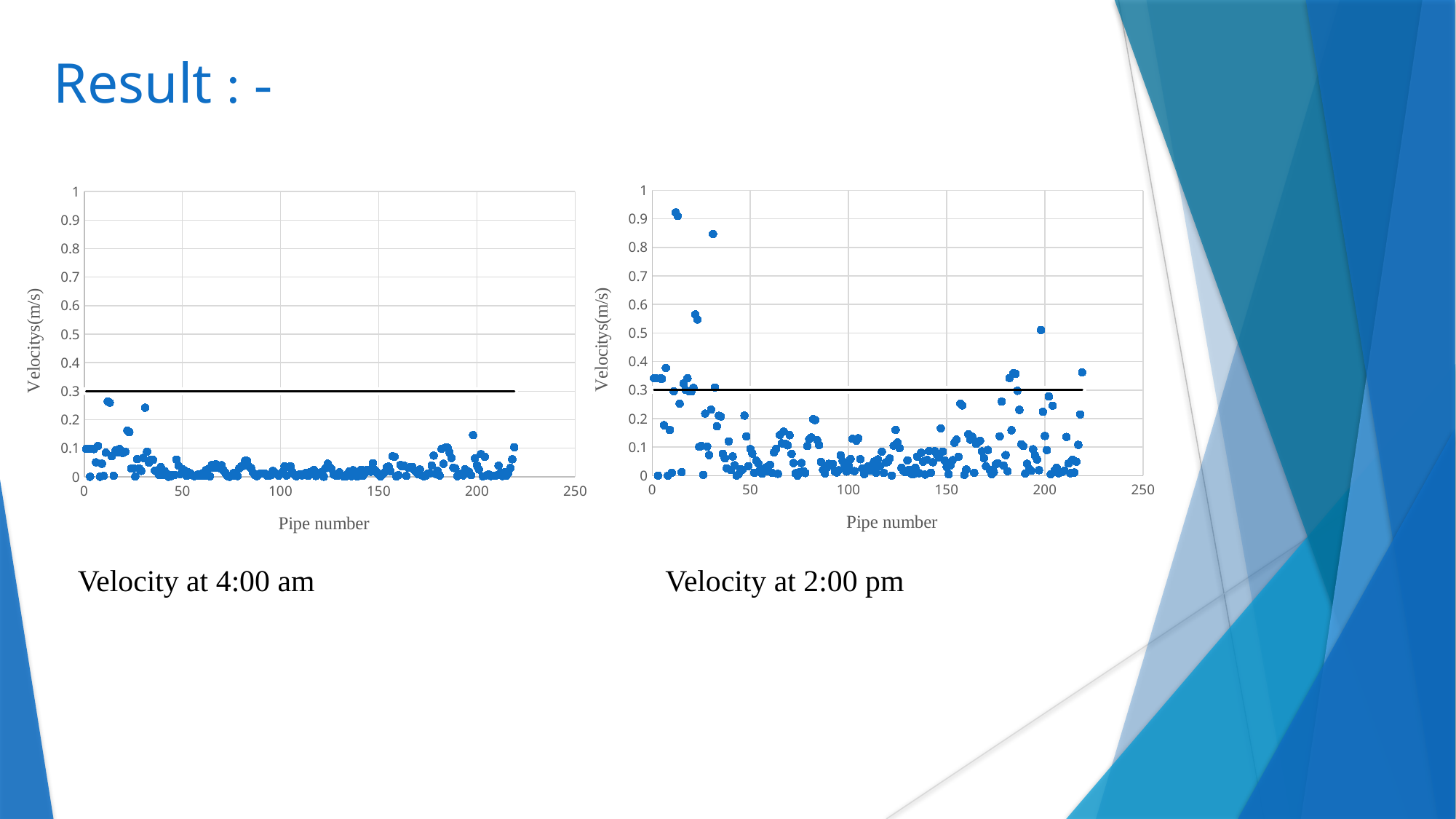
In the Velocity at 4:00 am chart, is the highest plotted velocity greater or less than 0.3? less Which chart has the higher maximum plotted velocity, Velocity at 4:00 am or Velocity at 2:00 pm? Velocity at 2:00 pm What kind of chart is the Velocity at 4:00 am chart? scatter chart In the Velocity at 2:00 pm chart, is the highest plotted velocity greater or less than 0.9? greater In the Velocity at 2:00 pm chart, is the point plotted near pipe number 30 greater or less than 0.8? greater How many charts are shown on the slide? 2 In the Velocity at 4:00 am chart, what is the highest tick value shown on the y axis? 1 In the Velocity at 2:00 pm chart, at what velocity value is the horizontal black line drawn? 0.3 What is the label of the y axis in the Velocity at 4:00 am chart? Velocitys(m/s) In the Velocity at 2:00 pm chart, what is the highest tick value shown on the x axis? 250 What is the label of the x axis in the Velocity at 2:00 pm chart? Pipe number